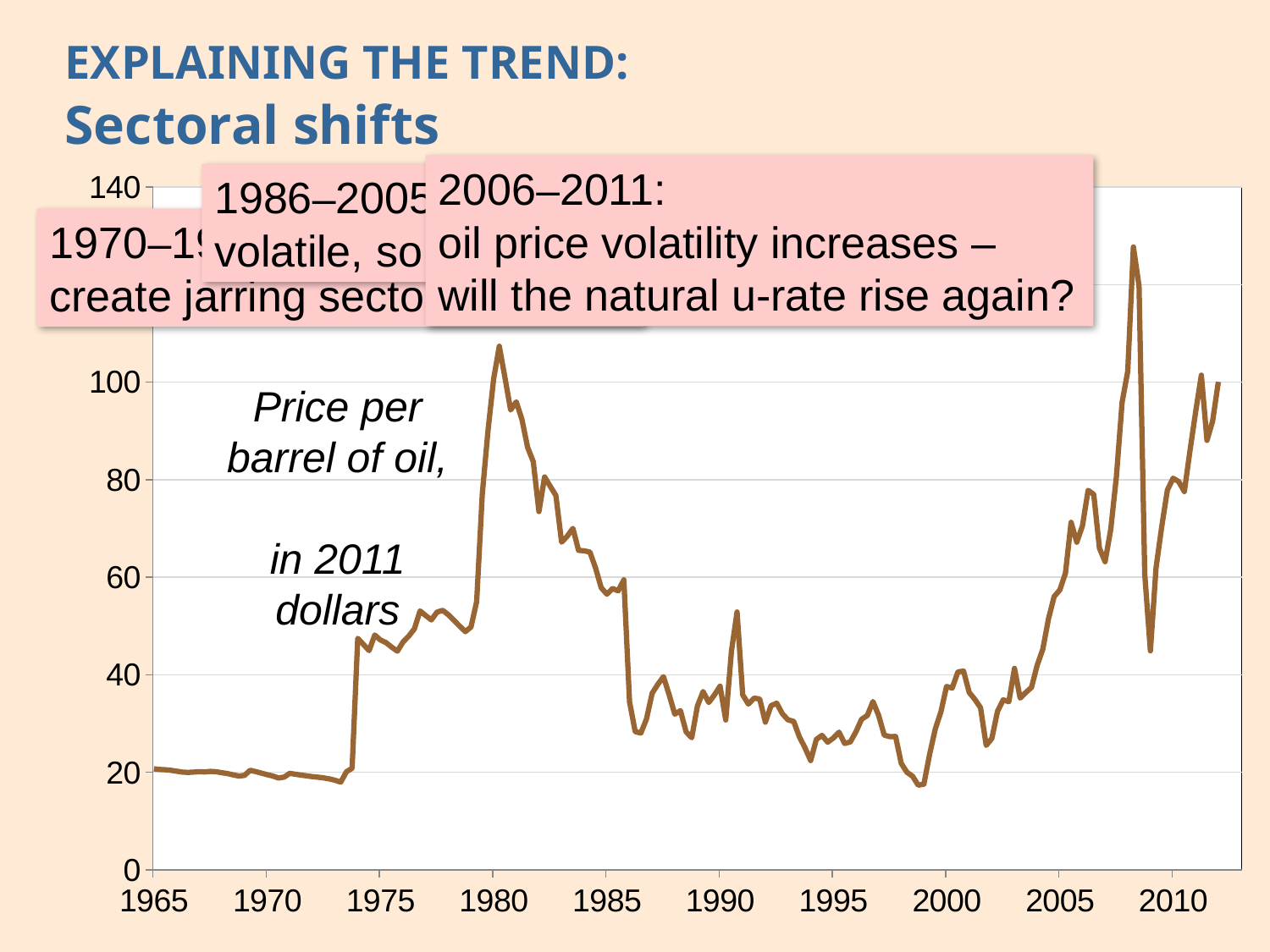
What kind of chart is shown on the slide? line chart Is the oil price in 1965 greater or less than 40? less What is the first year labelled on the x axis? 1965 Is the oil price in 2005 greater or less than 40? greater Does the oil price rise or fall between 1980 and 1986? fall Is the oil price in 1998 greater or less than 40? less Which is higher, the oil price in 1980 or in 1990? 1980 What does the line on the chart represent, according to the label inside the plot area? Price per barrel of oil, in 2011 dollars Does the oil price rise or fall between 1999 and 2008? rise